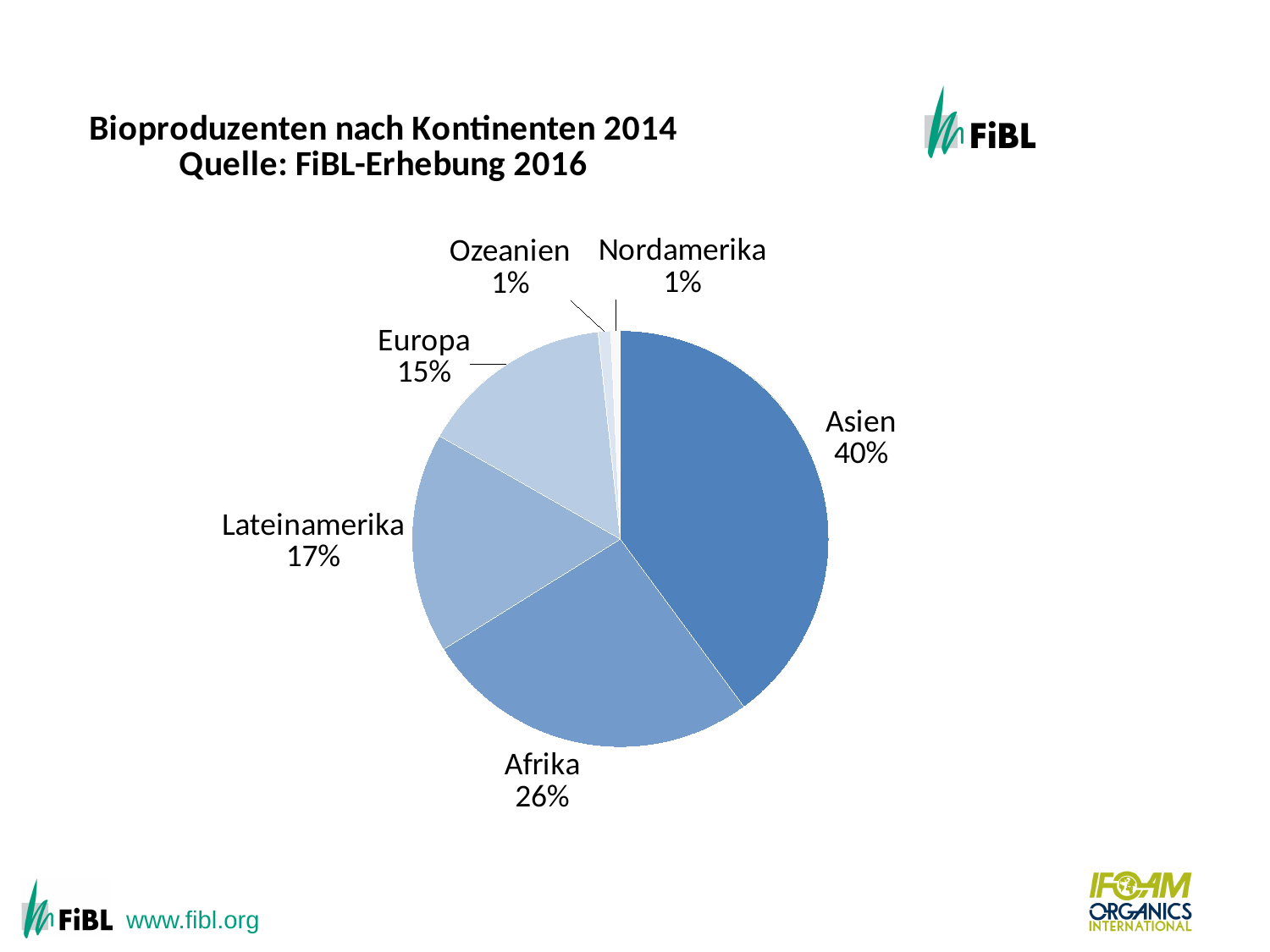
What percentage is shown for Afrika? 26% Which two continents each have a share of 1%? Ozeanien and Nordamerika What is the difference in percentage points between Asien and Afrika? 14 What percentage is shown for Lateinamerika? 17% Which is larger, the share for Lateinamerika or the share for Europa? Lateinamerika What is the combined share of Ozeanien and Nordamerika? 2% How many slices does the pie chart have? 6 What is the title of the chart? Bioproduzenten nach Kontinenten 2014 Quelle: FiBL-Erhebung 2016 What share of organic producers does Asien account for? 40% What kind of chart is shown on the slide? pie chart Which continent has the largest slice of the pie? Asien What percentage is shown for Europa? 15%